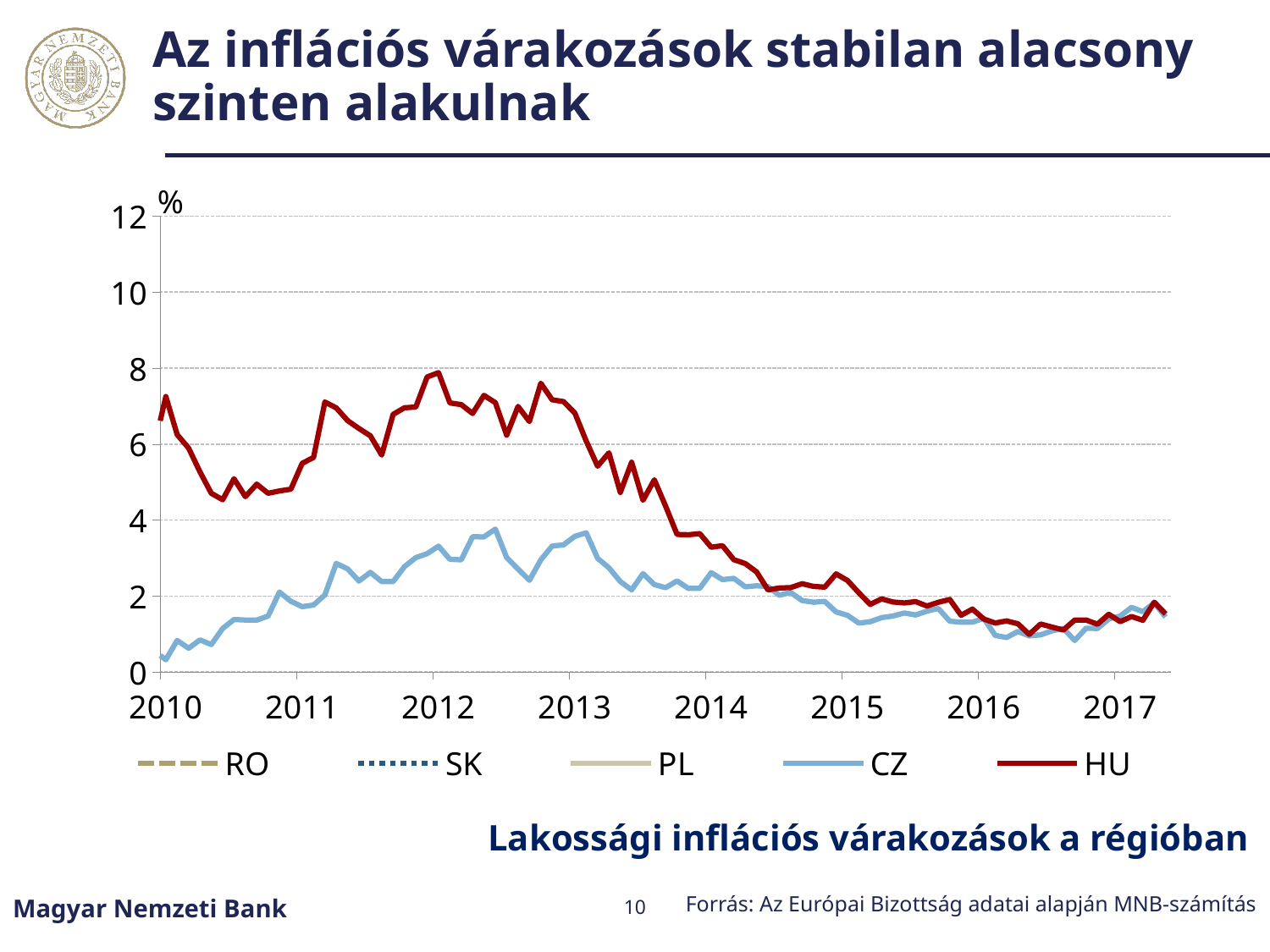
Which series reaches the highest value on the chart? HU Does the HU series rise or fall between 2013 and 2016? fall Is the value for HU at the start of 2010 greater or less than 6? greater Is the value for CZ at the start of 2012 greater or less than 2? greater What unit is shown on the vertical axis? % What is the title of the chart? Lakossági inflációs várakozások a régióban Which series is higher at the start of 2012, HU or CZ? HU How many series does the legend list? 5 Is the value for HU at the start of 2017 greater or less than 4? less What kind of chart is shown on the slide? line chart